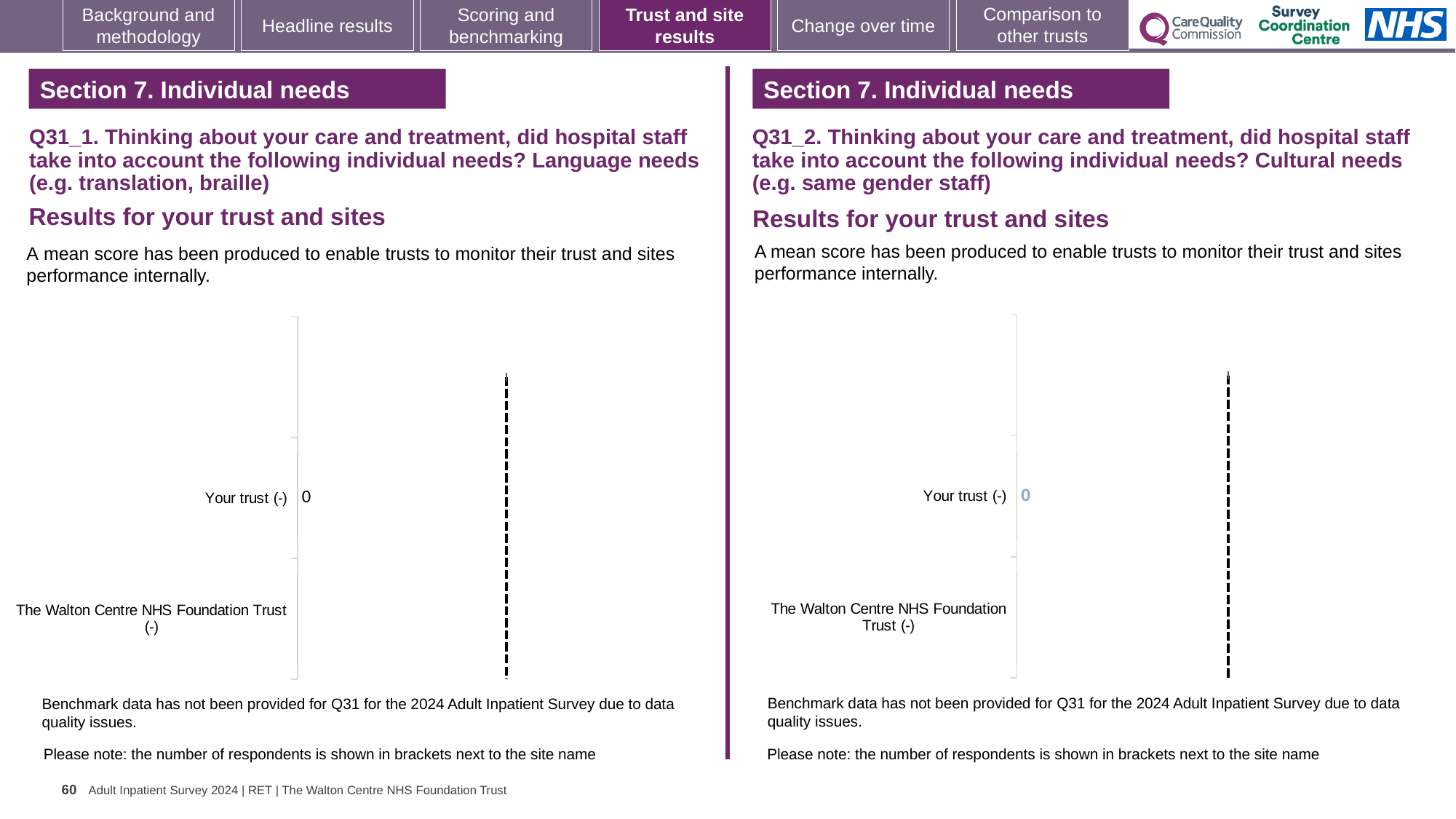
On the left chart (Q31_1, Language needs), what is the label of the category below Your trust? The Walton Centre NHS Foundation Trust (-) On the right chart (Q31_2, Cultural needs), what value is shown for Your trust? 0 On the left chart (Q31_1, Language needs), how many categories are listed on the vertical axis? 2 What kind of chart is the left chart (Q31_1, Language needs)? Bar chart On the right chart (Q31_2, Cultural needs), how many categories are listed on the vertical axis? 2 On the left chart (Q31_1, Language needs), what value is shown for Your trust? 0 According to the note under the right chart (Q31_2, Cultural needs), why has benchmark data not been provided for Q31? Due to data quality issues What kind of chart is the right chart (Q31_2, Cultural needs)? Bar chart